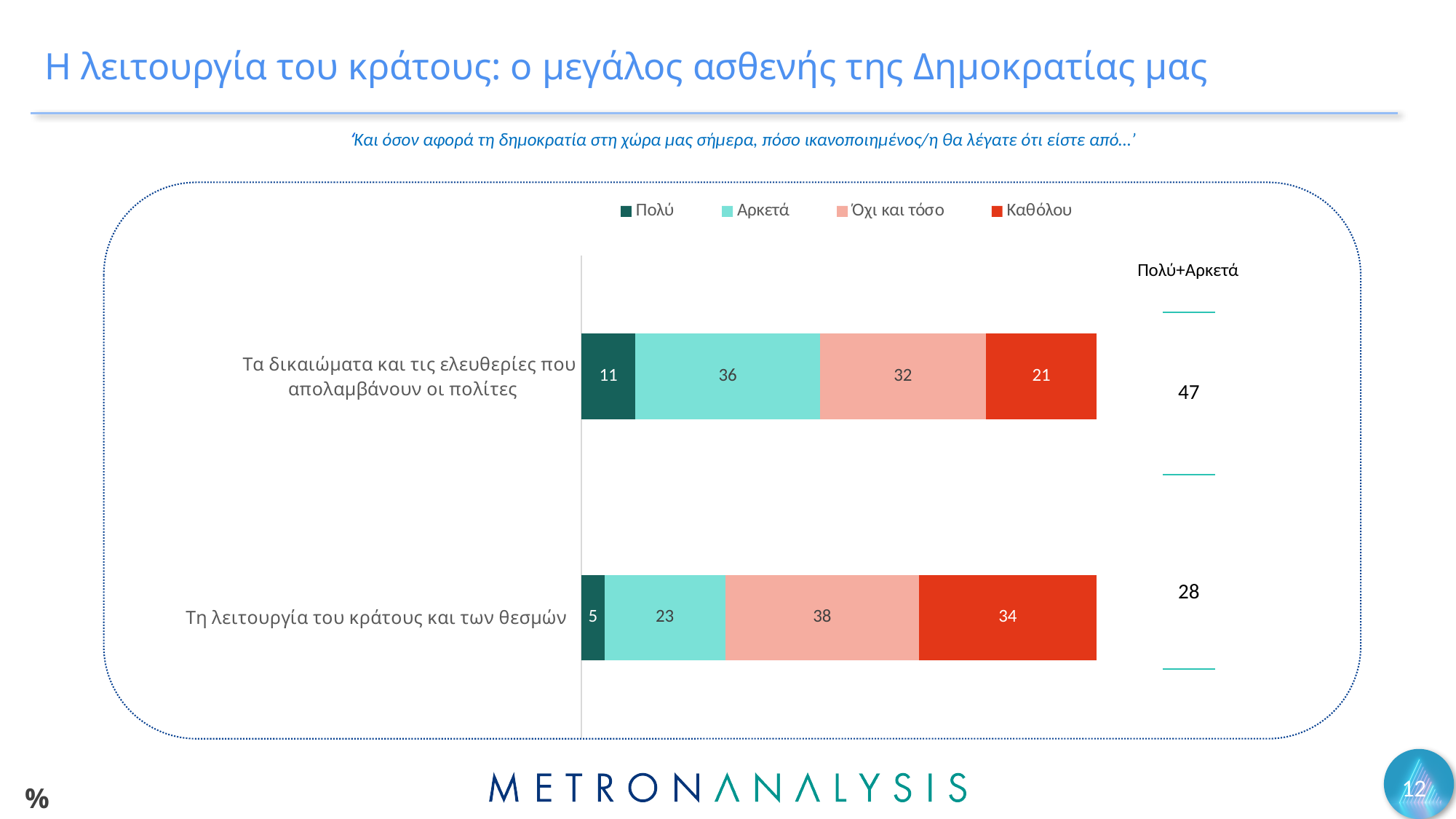
Which category has the lower 'Πολύ' value? Τη λειτουργία του κράτους και των θεσμών What kind of chart is shown on the slide? Stacked bar chart Is the 'Αρκετά' value larger for 'Τα δικαιώματα και τις ελευθερίες που απολαμβάνουν οι πολίτες' or for 'Τη λειτουργία του κράτους και των θεσμών'? Τα δικαιώματα και τις ελευθερίες που απολαμβάνουν οι πολίτες What is the total of the stacked bar for 'Τη λειτουργία του κράτους και των θεσμών'? 100 How many categories are shown in the chart? 2 What is the 'Πολύ+Αρκετά' value shown for 'Τα δικαιώματα και τις ελευθερίες που απολαμβάνουν οι πολίτες'? 47 Which category has the higher 'Καθόλου' value? Τη λειτουργία του κράτους και των θεσμών How many series does the legend list? 4 What is the value for 'Αρκετά' for 'Τα δικαιώματα και τις ελευθερίες που απολαμβάνουν οι πολίτες'? 36 What is the value for 'Πολύ' for 'Τη λειτουργία του κράτους και των θεσμών'? 5 What is the difference between the 'Όχι και τόσο' values of the two categories? 6 What is the value for 'Καθόλου' for 'Τη λειτουργία του κράτους και των θεσμών'? 34